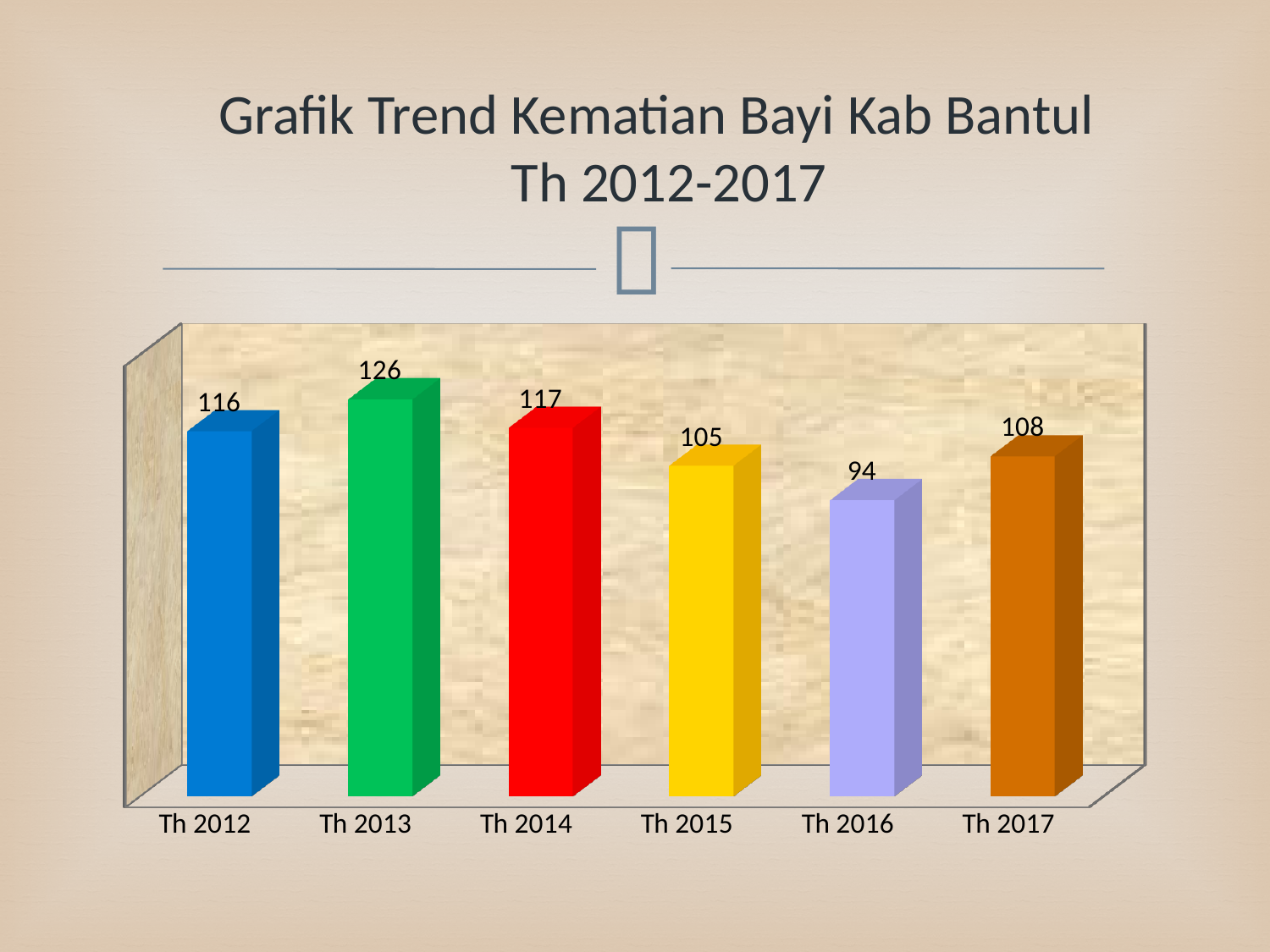
How many years are shown on the chart? 6 What is the difference between the values for Th 2013 and Th 2016? 32 What is the value for Th 2017? 108 What is the value for Th 2012? 116 What is the value for Th 2016? 94 Do the values rise or fall from Th 2013 to Th 2016? Fall What kind of chart is shown on the slide? Bar chart What is the difference between the values for Th 2014 and Th 2015? 12 Which is larger, the value for Th 2015 or the value for Th 2017? Th 2017 What is the title of the chart on the slide? Grafik Trend Kematian Bayi Kab Bantul Th 2012-2017 Which year has the highest value? Th 2013 Which year has the lowest value? Th 2016